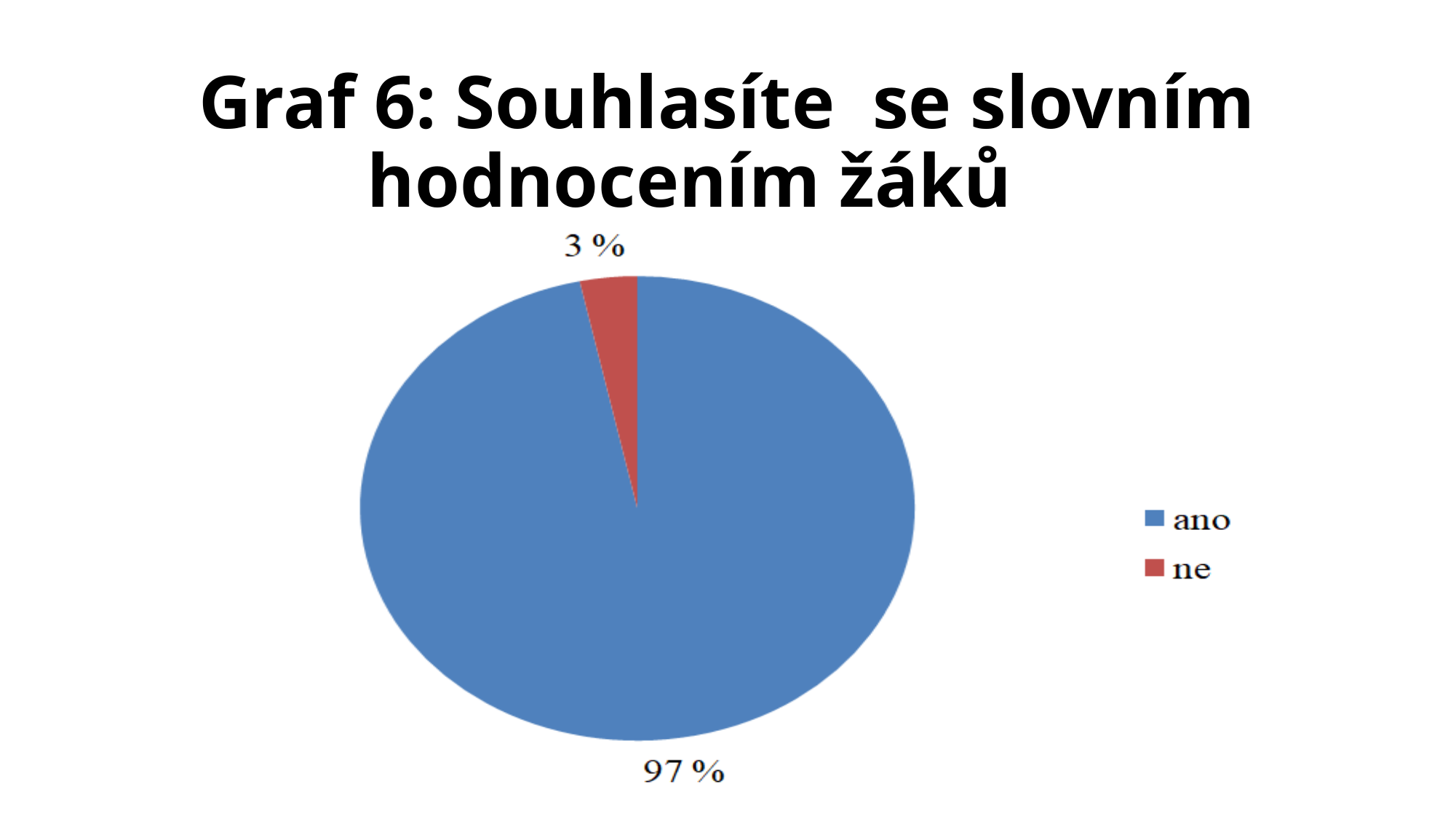
Which slice is the largest? ano Which slice is the smallest? ne How many entries does the legend list? 2 What colour is the "ne" slice? red Which is larger, the "ano" slice or the "ne" slice? ano What is the difference in percentage points between the "ano" and "ne" slices? 94 What share of the pie does "ano" take? 97 % How many slices does the pie chart have? 2 What is the title of the chart? Graf 6: Souhlasíte se slovním hodnocením žáků What share of the pie does "ne" take? 3 % What kind of chart is shown on the slide? pie chart